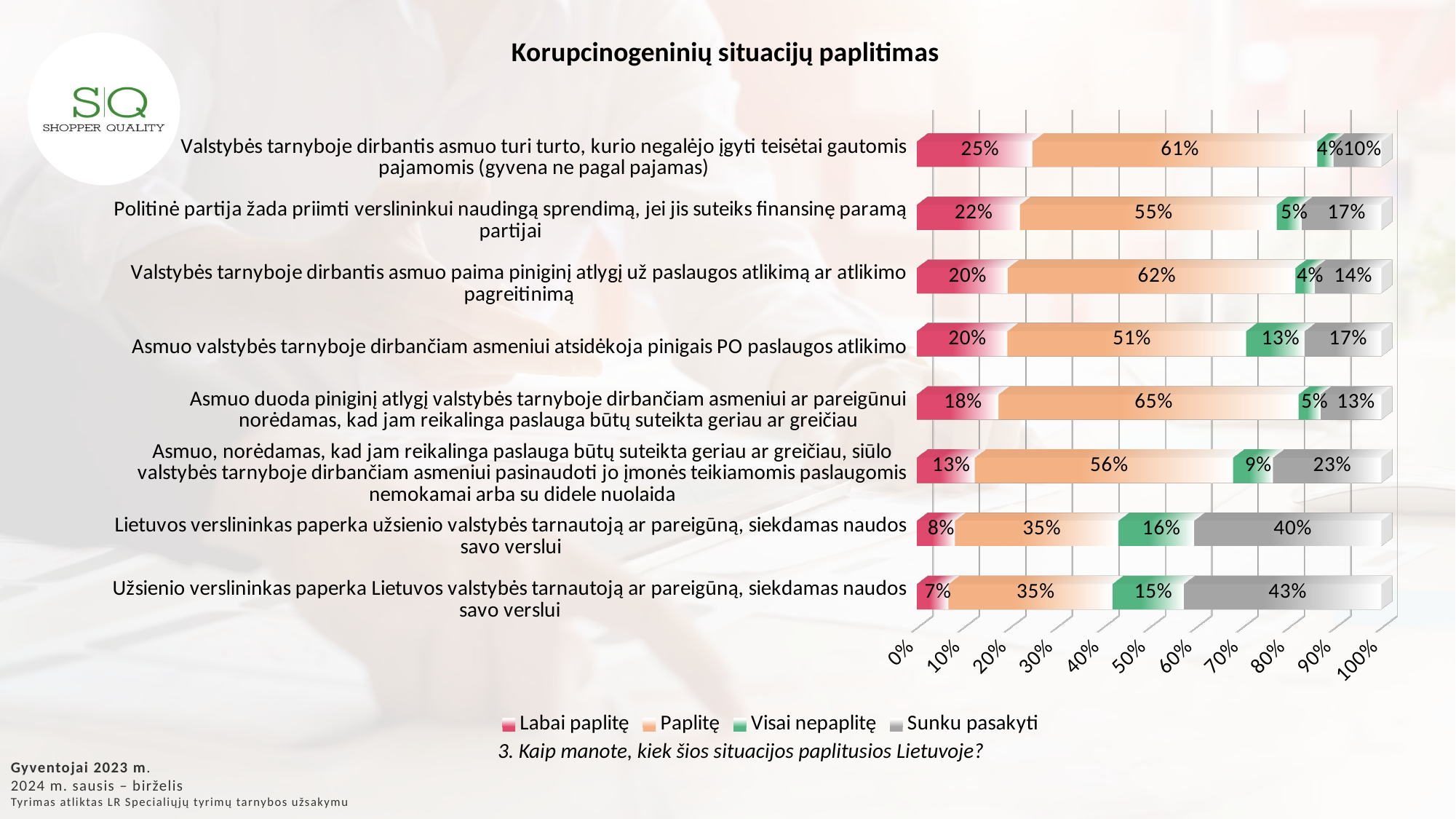
Which is larger: the 'Paplitę' value for 'Politinė partija žada priimti verslininkui naudingą sprendimą, jei jis suteiks finansinę paramą partijai' or for 'Valstybės tarnyboje dirbantis asmuo paima piniginį atlygį už paslaugos atlikimą ar atlikimo pagreitinimą'? Valstybės tarnyboje dirbantis asmuo paima piniginį atlygį už paslaugos atlikimą ar atlikimo pagreitinimą Which category has the highest 'Labai paplitę' value? Valstybės tarnyboje dirbantis asmuo turi turto, kurio negalėjo įgyti teisėtai gautomis pajamomis (gyvena ne pagal pajamas) What is the 'Labai paplitę' value for 'Valstybės tarnyboje dirbantis asmuo turi turto, kurio negalėjo įgyti teisėtai gautomis pajamomis (gyvena ne pagal pajamas)'? 25% What is the 'Sunku pasakyti' value for 'Užsienio verslininkas paperka Lietuvos valstybės tarnautoją ar pareigūną, siekdamas naudos savo verslui'? 43% Which category has the highest 'Visai nepaplitę' value? Lietuvos verslininkas paperka užsienio valstybės tarnautoją ar pareigūną, siekdamas naudos savo verslui What is the 'Paplitę' value for 'Asmuo duoda piniginį atlygį valstybės tarnyboje dirbančiam asmeniui ar pareigūnui norėdamas, kad jam reikalinga paslauga būtų suteikta geriau ar greičiau'? 65% How many series does the legend list? 4 Which category has the lowest 'Labai paplitę' value? Užsienio verslininkas paperka Lietuvos valstybės tarnautoją ar pareigūną, siekdamas naudos savo verslui What is the title of the chart? Korupcinogeninių situacijų paplitimas What type of chart is shown on the slide? Stacked bar chart What is the difference between the 'Sunku pasakyti' values for 'Lietuvos verslininkas paperka užsienio valstybės tarnautoją ar pareigūną, siekdamas naudos savo verslui' and 'Asmuo, norėdamas, kad jam reikalinga paslauga būtų suteikta geriau ar greičiau, siūlo valstybės tarnyboje dirbančiam asmeniui pasinaudoti jo įmonės teikiamomis paslaugomis nemokamai arba su didele nuolaida'? 17% How many categories (situations) are plotted in the chart? 8